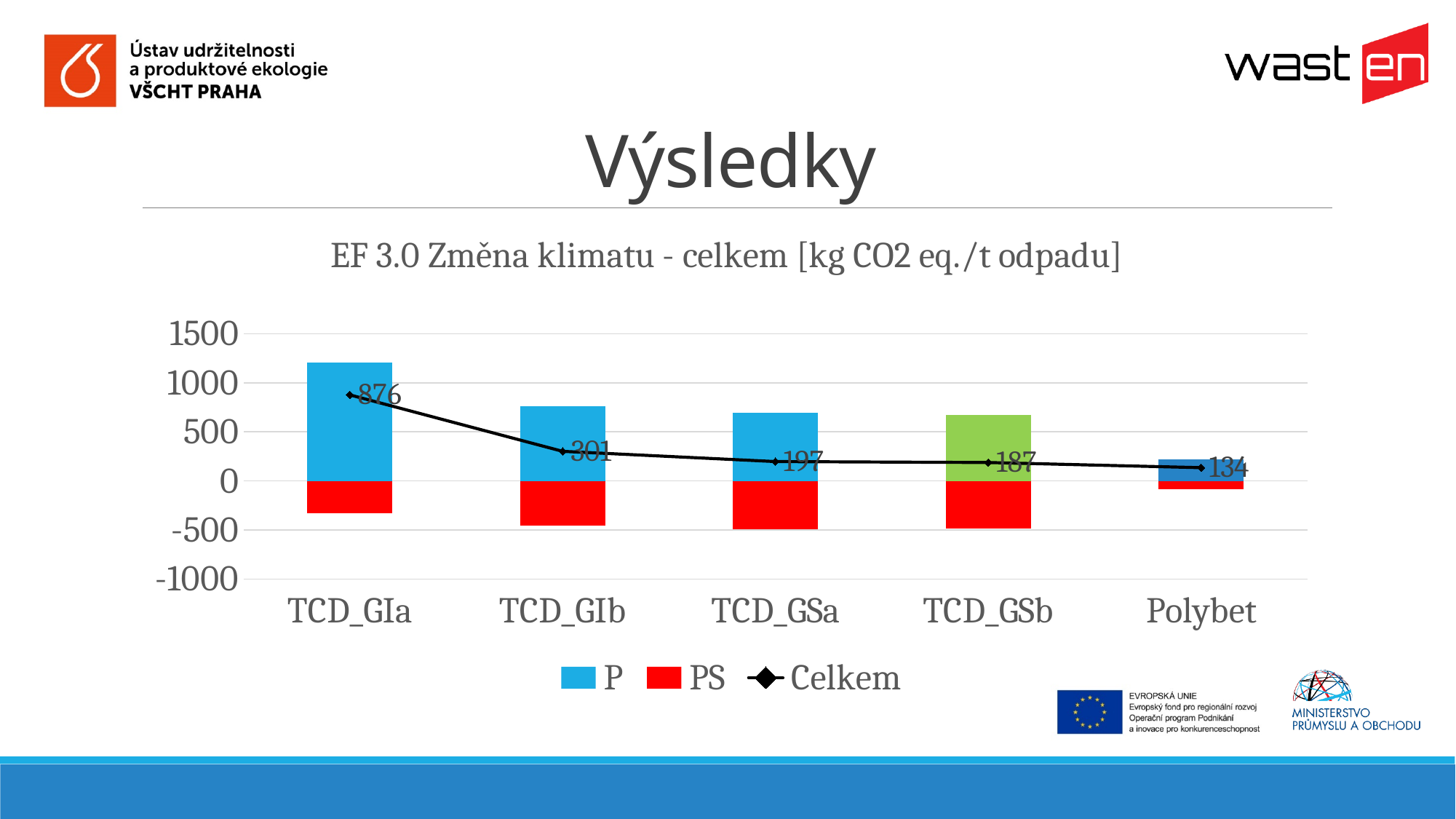
Is the P value for TCD_GIa greater or less than 1000? greater What is the Celkem value for TCD_GIa? 876 What is the Celkem value for Polybet? 134 Which category has the lowest Celkem value? Polybet Do the Celkem values rise or fall from TCD_GIa to Polybet? fall How many series does the legend list? 3 What is the difference between the Celkem values for TCD_GIa and TCD_GIb? 575 Which has the larger Celkem value, TCD_GSa or TCD_GSb? TCD_GSa What is the Celkem value for TCD_GSb? 187 Which category has the highest Celkem value? TCD_GIa How many categories are shown on the x axis? 5 Is the P value for Polybet greater or less than 500? less